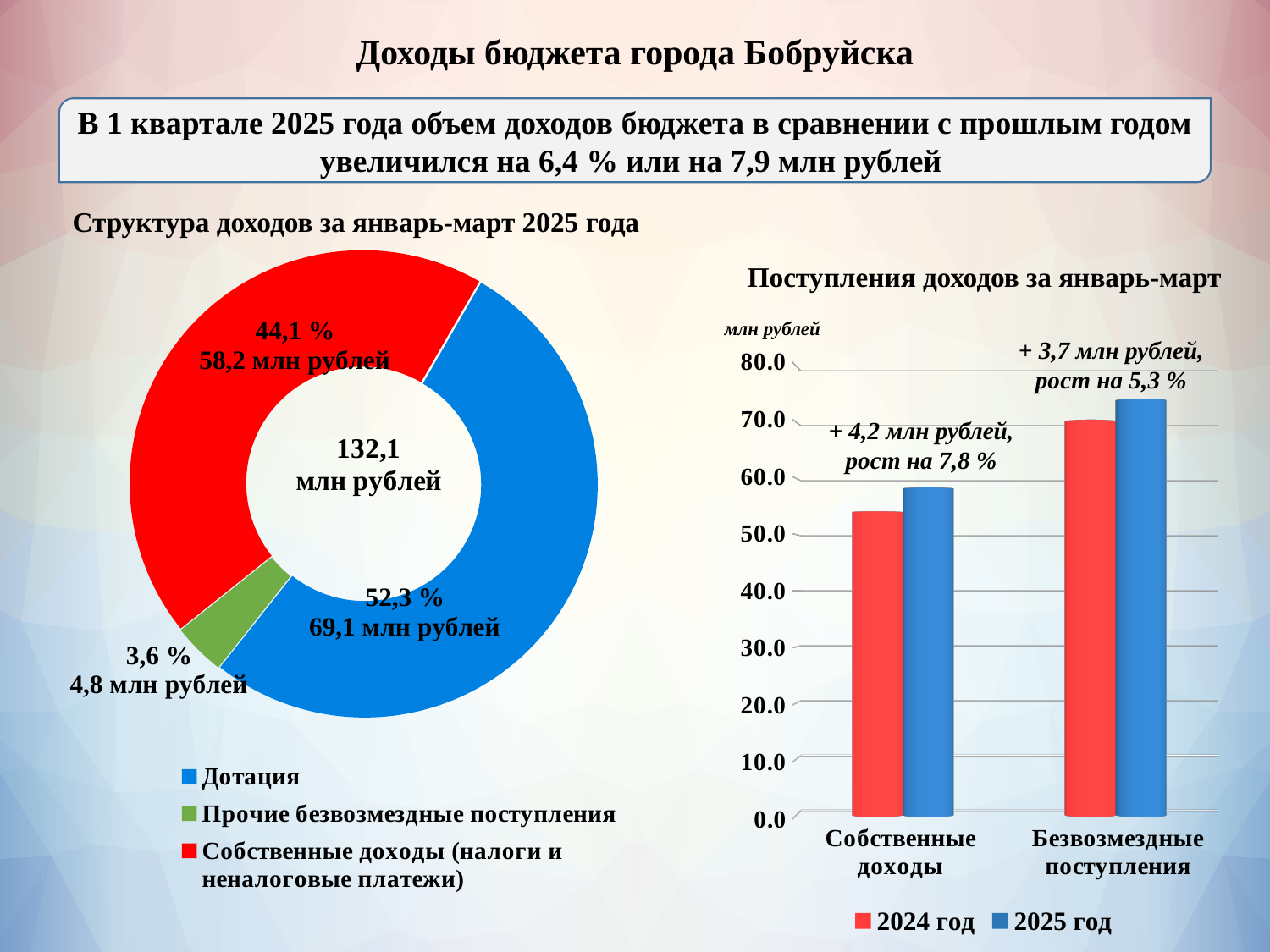
In the bar chart 'Поступления доходов за январь-март', is the 2024 год value for 'Собственные доходы' greater or less than 60.0? less What kind of chart is 'Поступления доходов за январь-март'? bar chart In the donut chart 'Структура доходов за январь-март 2025 года', what is the value for 'Прочие безвозмездные поступления'? 4,8 млн рублей In the bar chart 'Поступления доходов за январь-март', which category has the higher 2025 год value: 'Собственные доходы' or 'Безвозмездные поступления'? Безвозмездные поступления In the bar chart 'Поступления доходов за январь-март', how many series does the legend list? 2 In the donut chart 'Структура доходов за январь-март 2025 года', which category has the largest share? Дотация In the donut chart 'Структура доходов за январь-март 2025 года', what is the value for 'Собственные доходы (налоги и неналоговые платежи)' in млн рублей? 58,2 млн рублей In the donut chart 'Структура доходов за январь-март 2025 года', what is the difference in млн рублей between 'Дотация' and 'Собственные доходы'? 10,9 млн рублей In the donut chart 'Структура доходов за январь-март 2025 года', how many categories does the legend list? 3 In the donut chart 'Структура доходов за январь-март 2025 года', which category has the smallest share? Прочие безвозмездные поступления In the donut chart 'Структура доходов за январь-март 2025 года', what total is shown in the centre? 132,1 млн рублей In the donut chart 'Структура доходов за январь-март 2025 года', what share does 'Дотация' have? 52,3 %